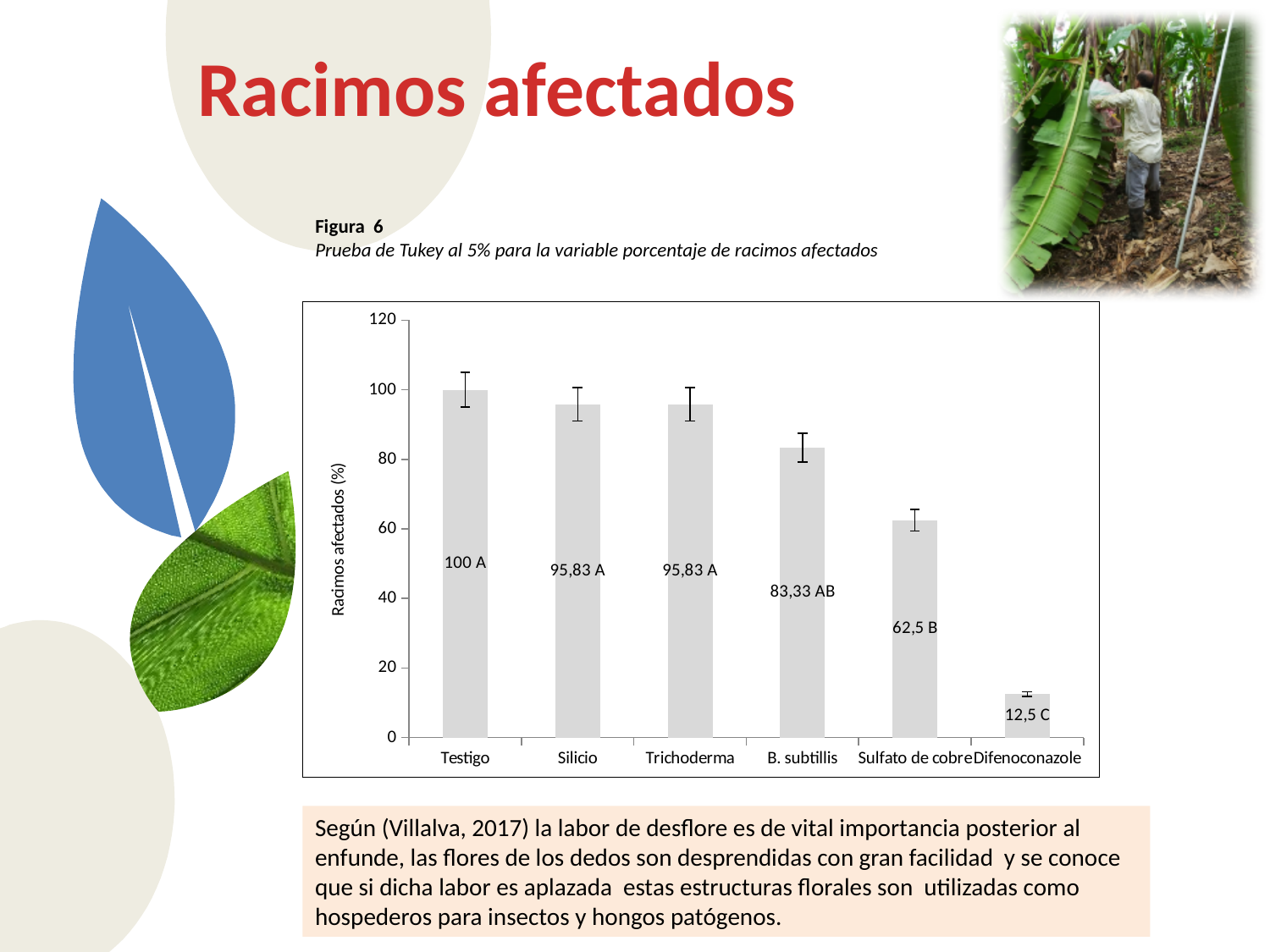
How many categories are shown on the x axis? 6 What is the difference between the values for Sulfato de cobre and Difenoconazole? 50 What is the label of the y axis? Racimos afectados (%) What is the difference between the values for Testigo and Difenoconazole? 87,5 Which category has the highest value? Testigo Which category has the lowest value? Difenoconazole What kind of chart is shown? Bar chart What is the value for B. subtillis? 83,33 What is the value for Testigo? 100 Which is larger, the value for B. subtillis or the value for Sulfato de cobre? B. subtillis What is the value for Difenoconazole? 12,5 What is the value for Sulfato de cobre? 62,5